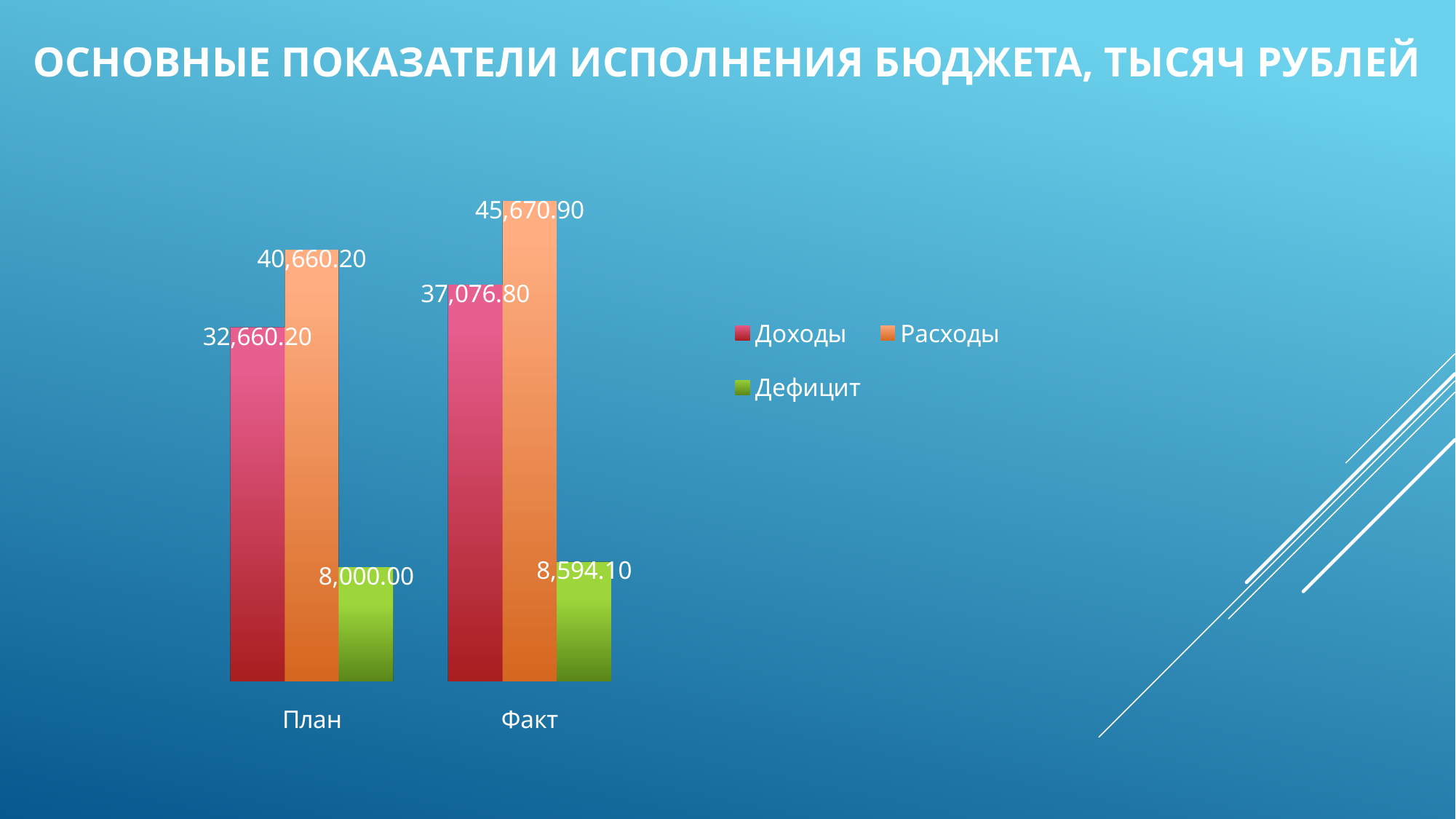
What is the value of Доходы for План? 32,660.20 Which is larger: Доходы for Факт or Расходы for План? Расходы for План What kind of chart is shown on the slide? Bar chart What is the difference between Расходы for Факт and Расходы for План? 5,010.70 What is the value of Дефицит for Факт? 8,594.10 Which series has the lowest value in the План category? Дефицит What is the value of Дефицит for План? 8,000.00 What is the value of Расходы for Факт? 45,670.90 How many series does the legend list? 3 How many categories are shown on the x axis? 2 What is the difference between Доходы for Факт and Доходы for План? 4,416.60 Which series has the highest value in the Факт category? Расходы